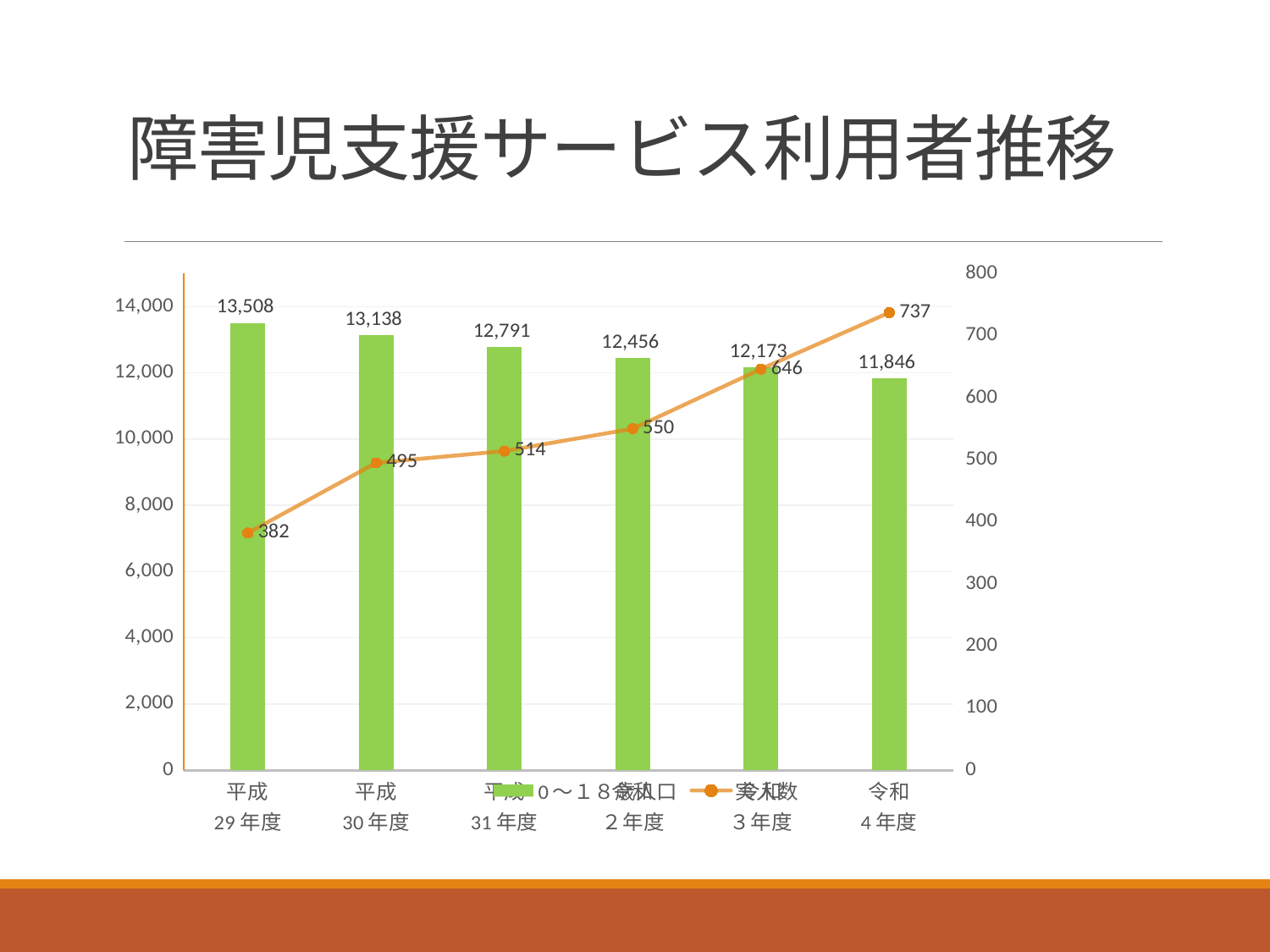
What is the value of the green bar for 平成29年度? 13,508 Do the green bar values rise or fall from 平成29年度 to 令和4年度? fall Which fiscal year has the highest orange line value? 令和4年度 Which is larger, the orange line value for 平成31年度 or for 令和3年度? 令和3年度 What is the value of the orange line point for 平成30年度? 495 What is the difference between the green bar values for 平成29年度 and 令和4年度? 1,662 Which fiscal year has the lowest green bar value? 令和4年度 How many fiscal years are shown on the x axis? 6 What is the title of the slide? 障害児支援サービス利用者推移 What is the difference between the orange line values for 令和3年度 and 令和2年度? 96 What is the value of the orange line point for 令和4年度? 737 What is the value of the green bar for 令和2年度? 12,456